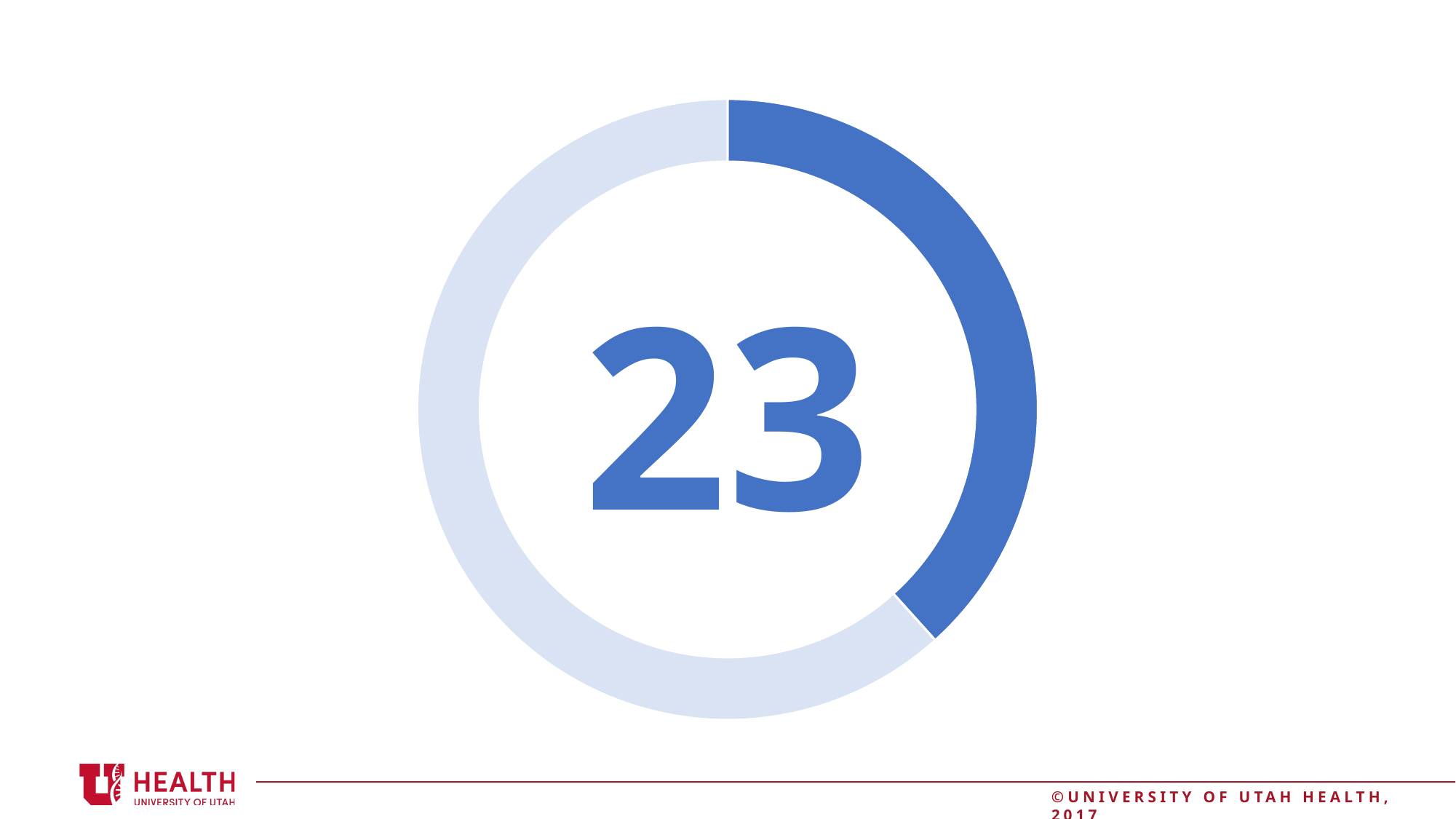
Does the dark blue segment cover more or less than half of the ring? Less How many segments does the doughnut chart have? 2 What number is displayed in the centre of the doughnut chart? 23 What kind of chart is shown on the slide? Doughnut chart Does the doughnut chart have a legend? No Which segment of the doughnut chart is larger, the dark blue one or the light blue one? The light blue one